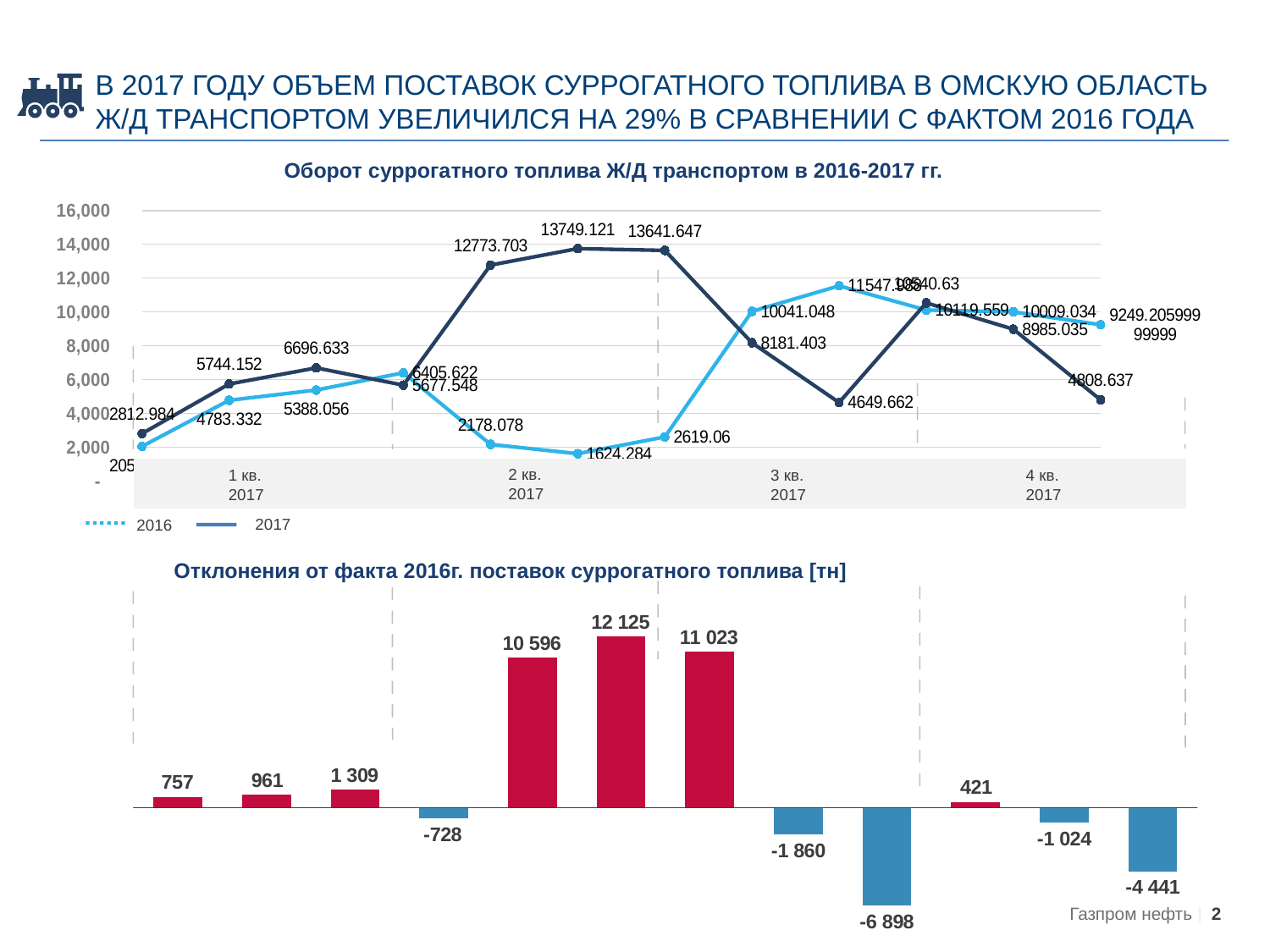
In the bottom chart, what is the difference between the bars labelled 12 125 and 10 596? 1 529 How many bars are plotted in the bottom chart? 12 What type of chart is the bottom chart titled 'Отклонения от факта 2016г. поставок суррогатного топлива [тн]'? Bar chart In the bottom chart, what is the highest value shown? 12 125 In the top chart, what is the lowest value of the 2016 series? 1624.284 In the top chart, what is the highest value of the 2017 series? 13749.121 How many series does the legend of the top chart list? 2 In the bottom chart, what is the lowest value shown? -6 898 In the top chart, is the peak of the 2017 series greater or less than 12,000? greater In the top chart, at the first point of 3 кв. 2017, which series is higher: 2016 (10041.048) or 2017 (8181.403)? 2016 What type of chart is the top chart titled 'Оборот суррогатного топлива Ж/Д транспортом в 2016-2017 гг.'? Line chart In the top chart, what is the first plotted value of the 2017 series? 2812.984